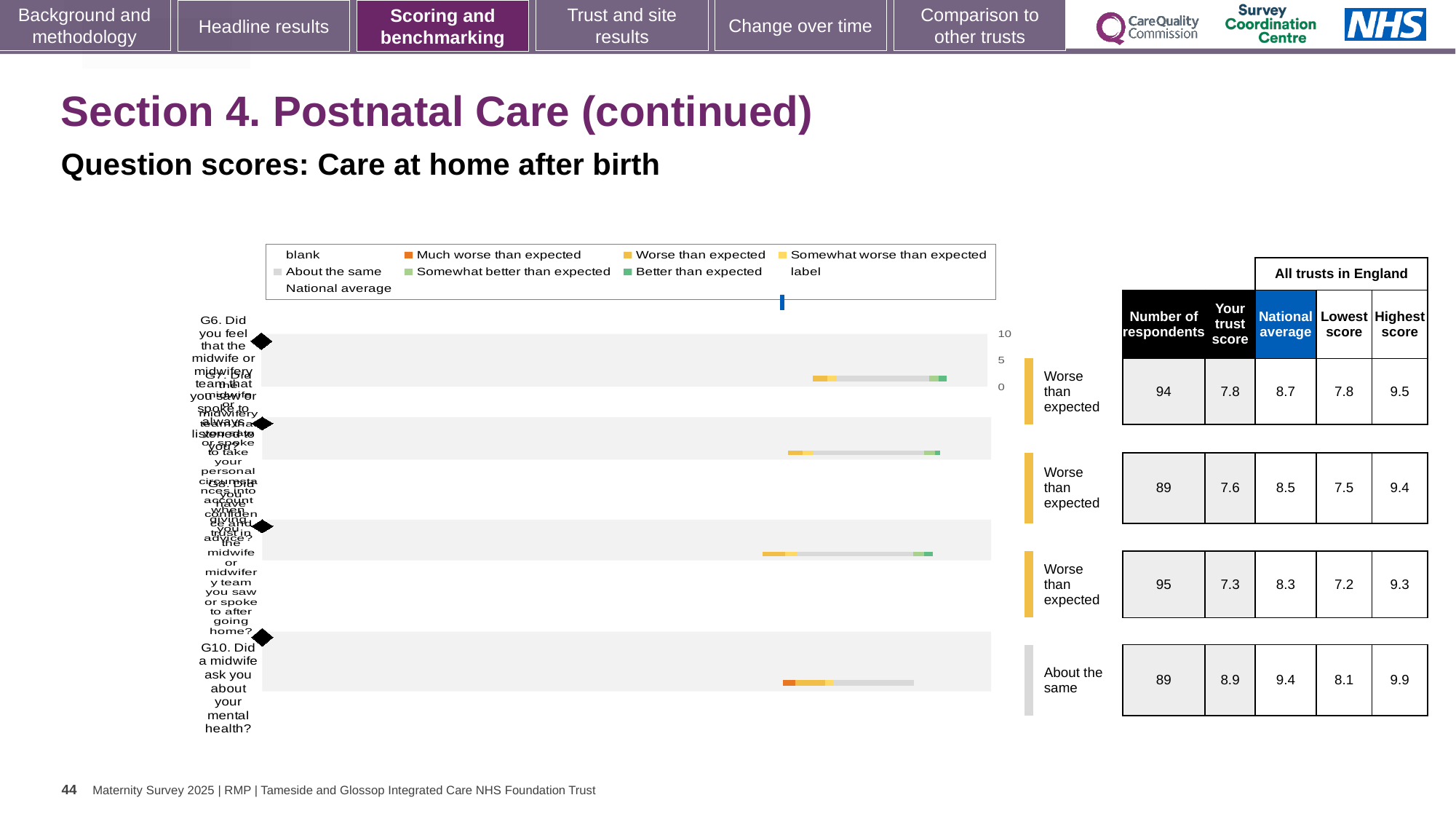
For G6, which is larger: the trust score or the national average? the national average (8.7) What benchmark label is given to the G10 row? About the same For G10, what is the difference between the national average and the trust score? 0.5 What is the national average for the first row, G6? 8.7 How many question rows (bars) does the chart show? 4 Which question row has the highest trust score? G10 (mental health), 8.9 How many respondents are listed for G10 (mental health)? 89 Which question row has the lowest trust score? the third row (G8), 7.3 What is the trust score for G10 (Did a midwife ask you about your mental health?)? 8.9 What kind of chart is shown on the slide? bar chart What is the highest score across all trusts in England for the first row, G6? 9.5 How many rows are labelled 'Worse than expected'? 3